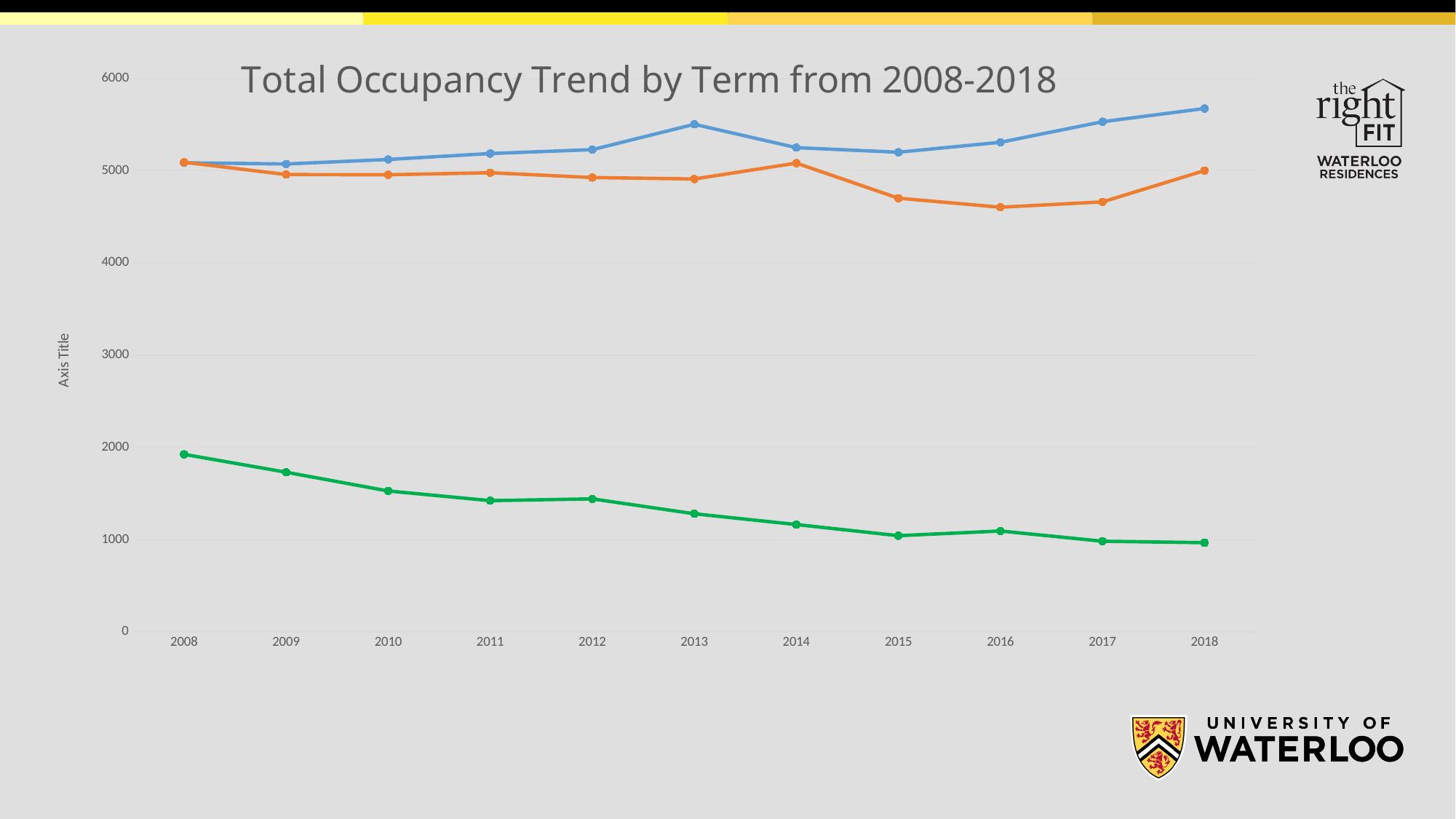
Does the blue line rise or fall from 2014 to 2018? rise Does the green line rise or fall from 2008 to 2018? fall What kind of chart is shown on the slide? line chart How many lines are plotted on the chart? 3 Is the value of the blue line in 2013 greater or less than 5000? greater In 2015, which line has the higher value, the blue line or the orange line? blue line Is the value of the green line in 2008 greater or less than 2000? less How many years are plotted along the x axis? 11 What is the title of the chart? Total Occupancy Trend by Term from 2008-2018 In which year does the green line reach its highest value? 2008 Is the value of the orange line in 2016 greater or less than 5000? less In which year does the blue line reach its highest value? 2018